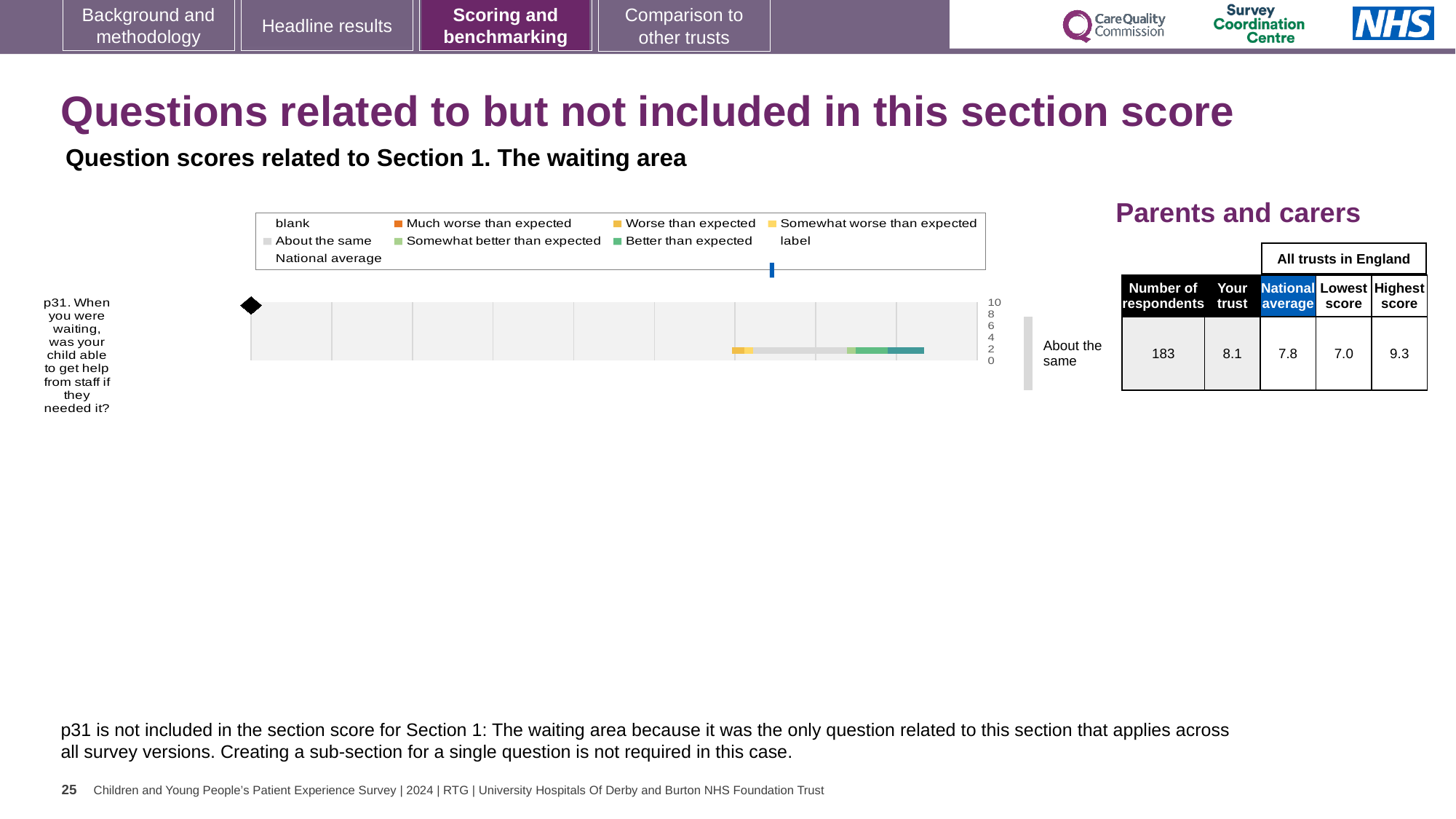
What kind of chart is shown on the slide? bar chart What benchmark label is shown next to the bar for p31? About the same How many questions (categories) are plotted in the chart? 1 Is the 'Your trust' score for p31 larger or smaller than the National average? larger What is the highest tick value shown on the chart's axis? 10 In the table beside the chart, what is the Lowest score among all trusts in England for p31? 7.0 Which question is plotted in the chart? p31. When you were waiting, was your child able to get help from staff if they needed it? In the table beside the chart, what is the Highest score among all trusts in England for p31? 9.3 In the table beside the chart, what is the 'Your trust' score for p31? 8.1 In the table beside the chart, what is the National average score for p31? 7.8 What is the difference between the Highest score and the Lowest score for p31 in the table? 2.3 In the table beside the chart, how many respondents answered p31? 183